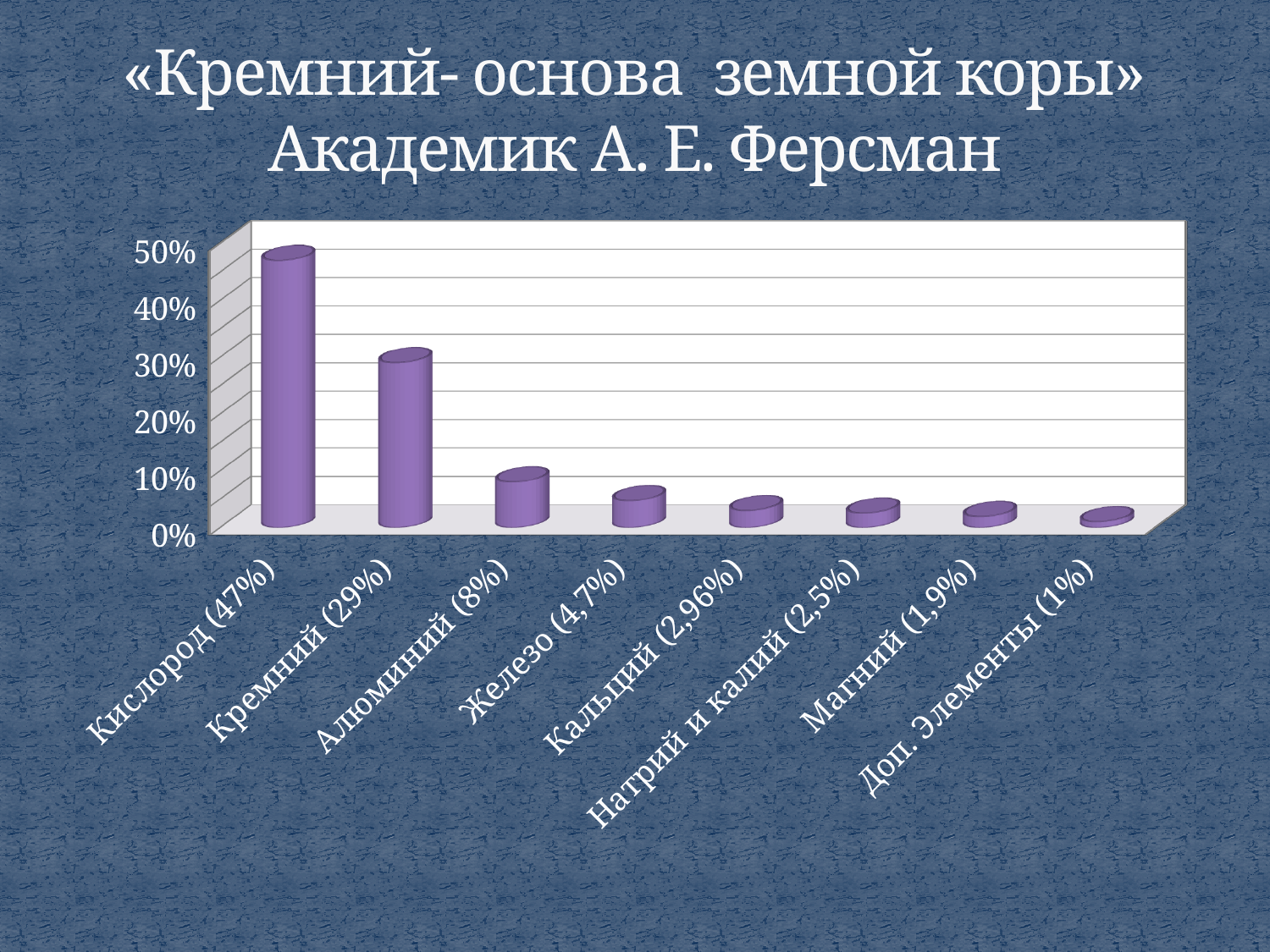
Which is larger, the value for Алюминий or the value for Железо? Алюминий Is the value for Кремний greater or less than 30%? less What is the difference between the percentages for Кислород (47%) and Кремний (29%)? 18% Which category has the highest value in the chart? Кислород (47%) Which category has the lowest value in the chart? Доп. Элементы (1%) Do the bar values rise or fall from left to right along the x axis? Fall What percentage is given for Кальций in the category label? 2,96% Is the value for Кислород greater or less than 40%? greater What kind of chart is shown on the slide? Bar chart What percentage is given for Кремний in the category label? 29% How many categories (bars) does the chart show? 8 What percentage is given for Железо in the category label? 4,7%